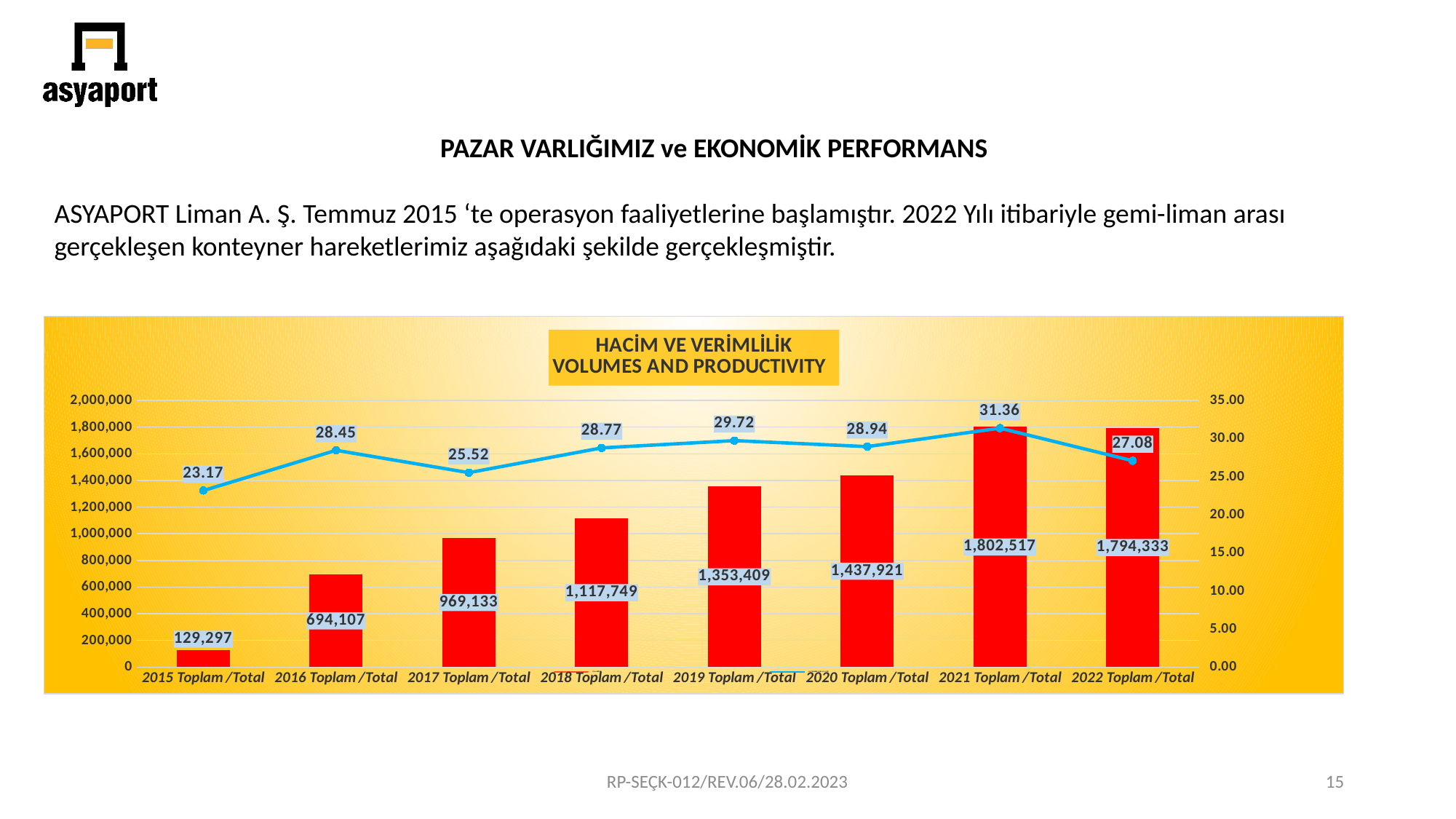
What value does the blue line show for 2021 Toplam /Total? 31.36 What is the difference between the red bar values for 2021 Toplam /Total and 2022 Toplam /Total? 8,184 How many categories are shown on the x axis? 8 Which category has the lowest value on the blue line? 2015 Toplam /Total Do the red bar values rise or fall from 2015 Toplam /Total to 2021 Toplam /Total? Rise What kind of chart is this? Combination bar and line chart By how much does the blue line value fall from 2021 Toplam /Total to 2022 Toplam /Total? 4.28 Which category has the tallest red bar? 2021 Toplam /Total What is the value of the red bar for 2019 Toplam /Total? 1,353,409 Which has the larger red bar value, 2017 Toplam /Total or 2018 Toplam /Total? 2018 Toplam /Total Is the blue line value for 2017 Toplam /Total greater or less than 30.00? less What is the title of the chart? HACİM VE VERİMLİLİK VOLUMES AND PRODUCTIVITY